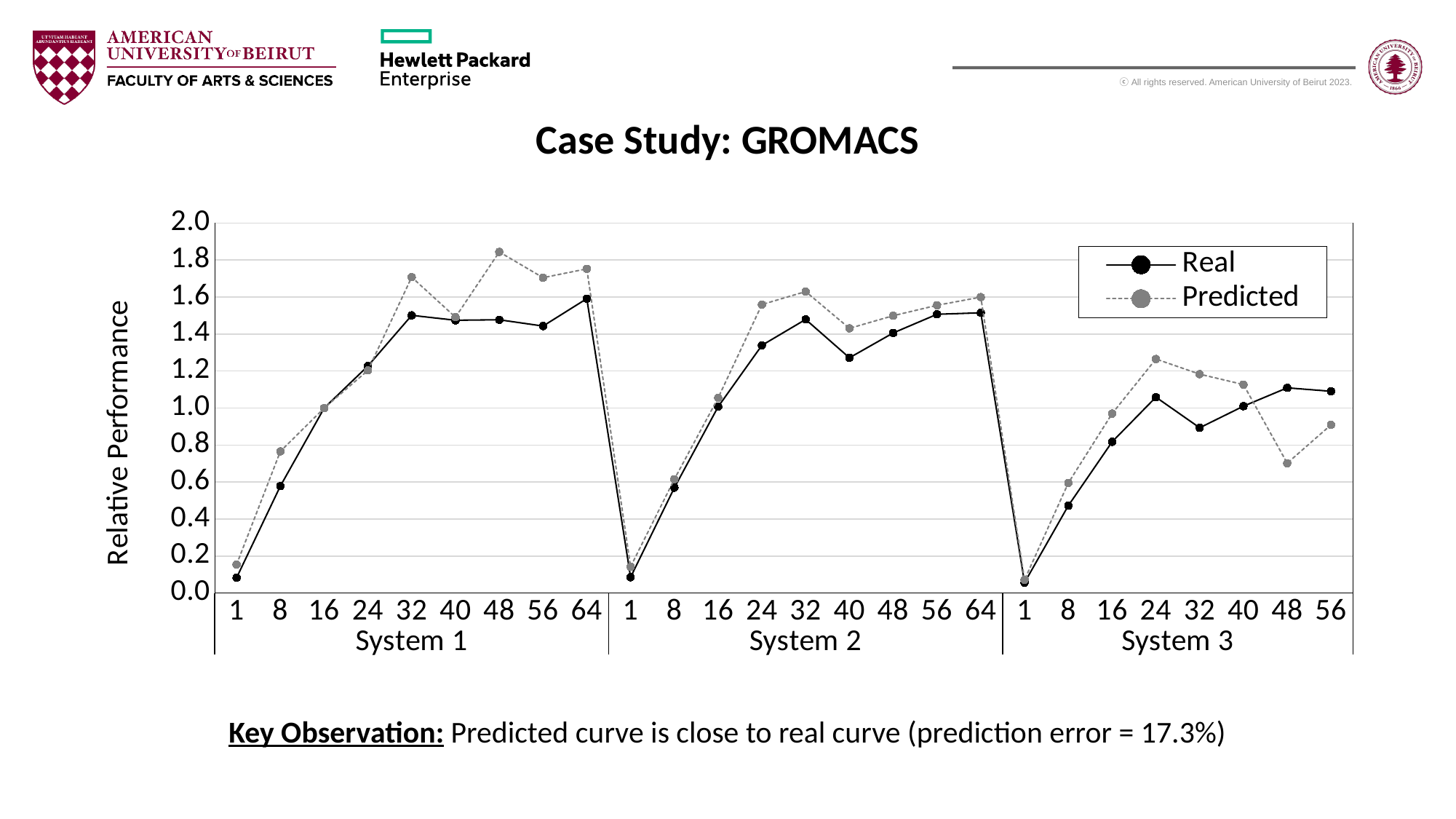
Is the Real value at 64 for System 1 greater or less than 1.4? greater What kind of chart is shown on the slide? Line chart What is the label of the y axis? Relative Performance How many x-axis points are plotted for System 1? 9 At 48 for System 1, which series has the larger value, Real or Predicted? Predicted Is the Predicted value at 48 for System 3 greater or less than 0.8? less How many x-axis points are plotted for System 3? 8 What are the two series named in the legend? Real and Predicted At 48 for System 3, which series has the larger value, Real or Predicted? Real How many series does the legend list? 2 Is the Predicted value at 48 for System 1 greater or less than 1.6? greater For System 1, does the Real series rise or fall from 1 to 32? Rise